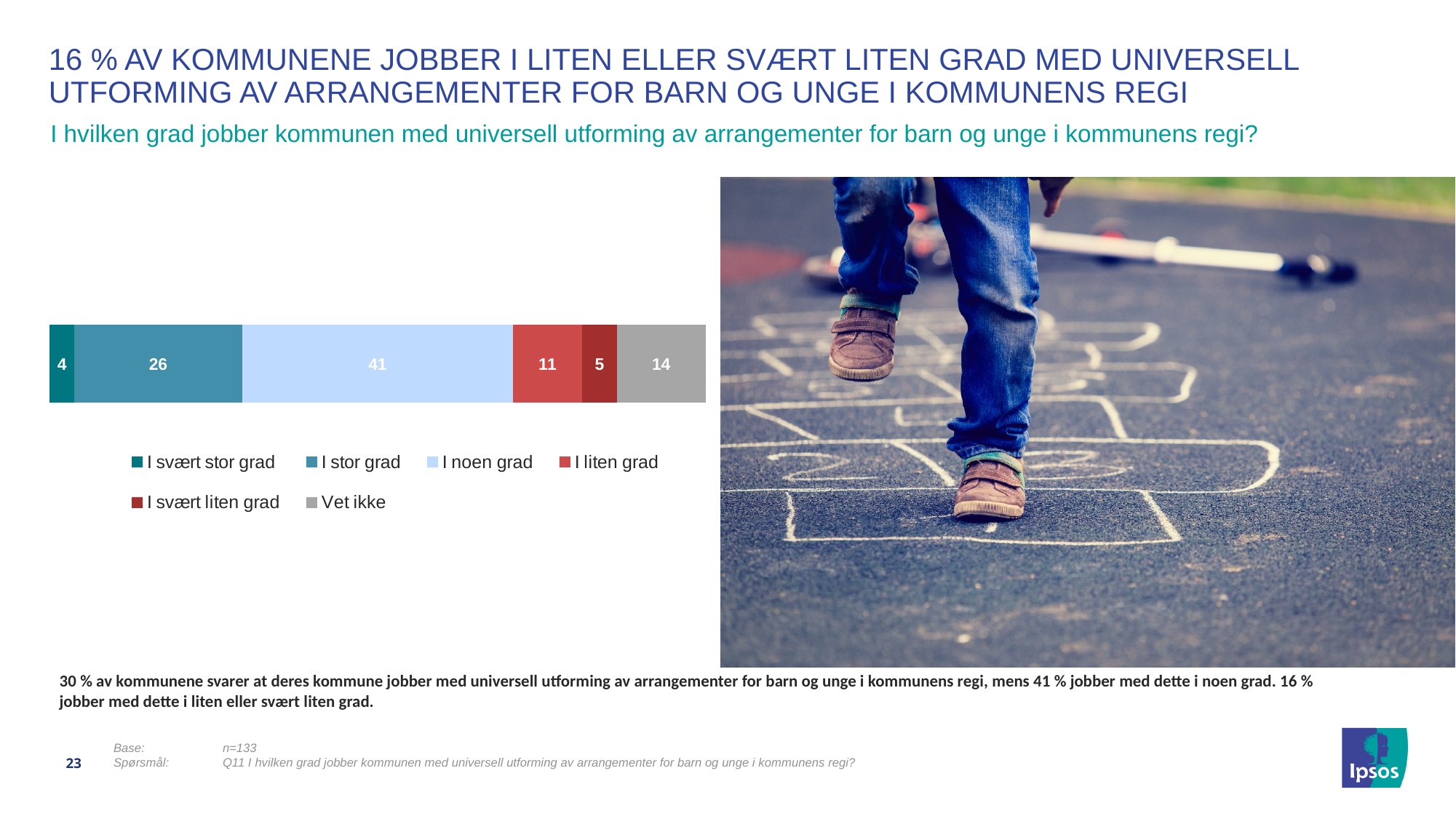
What is the difference between the 'I noen grad' and 'I stor grad' values? 15 What value is shown for the 'I noen grad' segment? 41 What value is shown for the 'Vet ikke' segment? 14 What colour is the 'Vet ikke' segment? Grey What value is shown for the 'I svært liten grad' segment? 5 Which is larger, the value for 'I liten grad' or the value for 'Vet ikke'? Vet ikke What is the combined total of the 'I liten grad' and 'I svært liten grad' segments? 16 Which segment has the highest value? I noen grad What kind of chart is shown on the slide? Stacked bar chart Which segment has the lowest value? I svært stor grad How many segments does the legend list? 6 What value is shown for the 'I stor grad' segment? 26